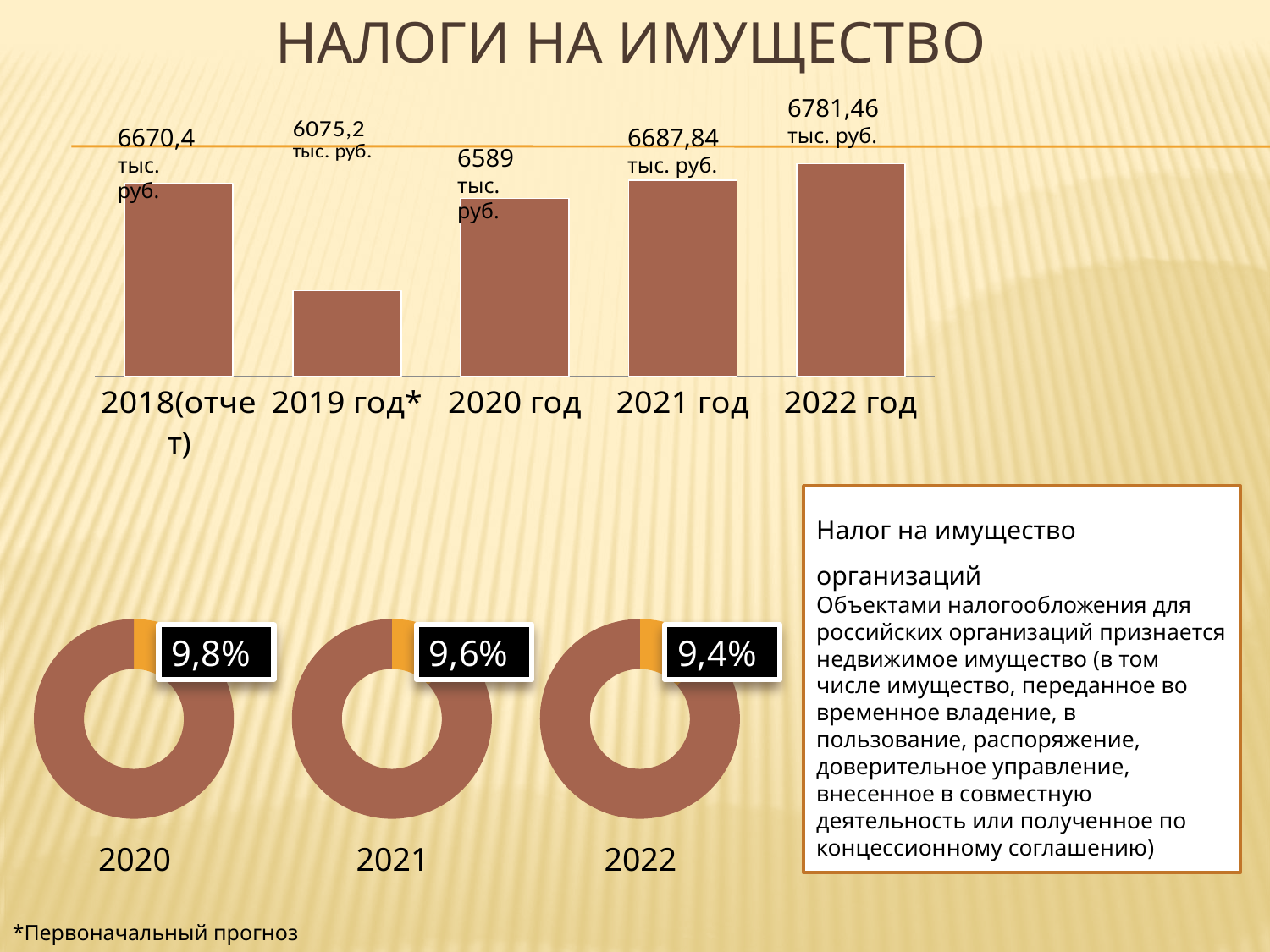
In the bar chart, what is the value for 2022 год? 6781,46 тыс. руб. In the bar chart, which year has the lowest value? 2019 год* In the bar chart, what is the value for 2019 год*? 6075,2 тыс. руб. In the bar chart, do the values rise or fall from 2019 год* to 2022 год? rise In the bar chart, which is larger: the value for 2018(отчет) or for 2021 год? 2021 год In the bar chart, what is the difference between the values for 2022 год and 2021 год? 93,62 тыс. руб. In the bar chart, what is the difference between the values for 2018(отчет) and 2019 год*? 595,2 тыс. руб. What kind of chart is shown in the top part of the slide? bar chart How many bars are in the bar chart? 5 In the donut chart labelled 2021, what percentage is shown? 9,6% In the bar chart, which year has the highest value? 2022 год In the bar chart, what is the value for 2020 год? 6589 тыс. руб.